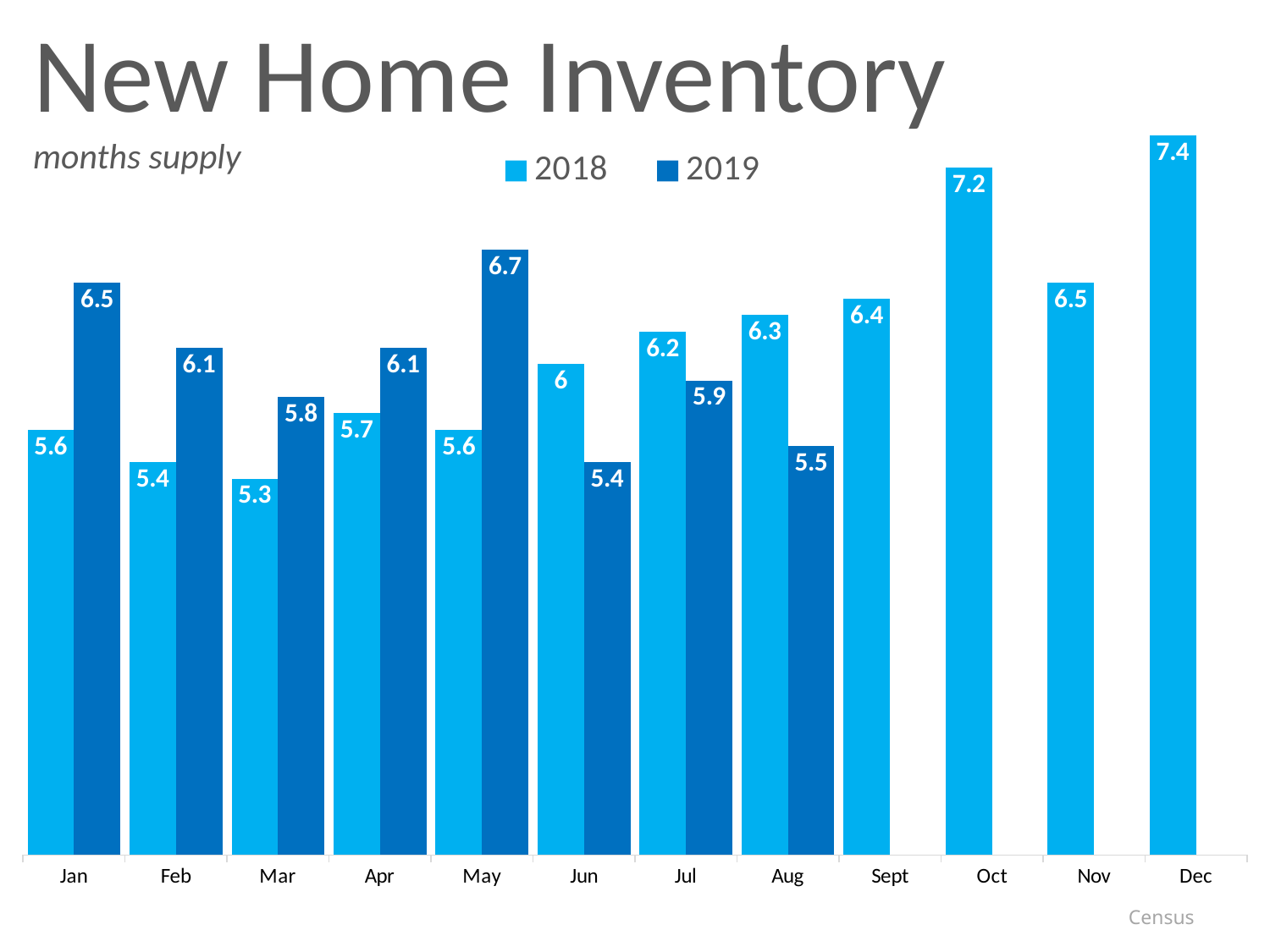
How many series does the legend list? 2 What is the 2018 value for Mar? 5.3 What is the title of the chart? New Home Inventory Which month has the lowest 2019 value? Jun Which is larger for Jun, the 2018 value or the 2019 value? 2018 Do the 2018 values rise or fall from Sept to Dec overall? Rise Which month has the highest 2018 value? Dec What kind of chart is shown on the slide? Bar chart How many months have a 2019 bar? 8 What is the 2019 months supply value for May? 6.7 What is the 2018 months supply value for Oct? 7.2 What is the difference between the 2019 and 2018 values for Jan? 0.9